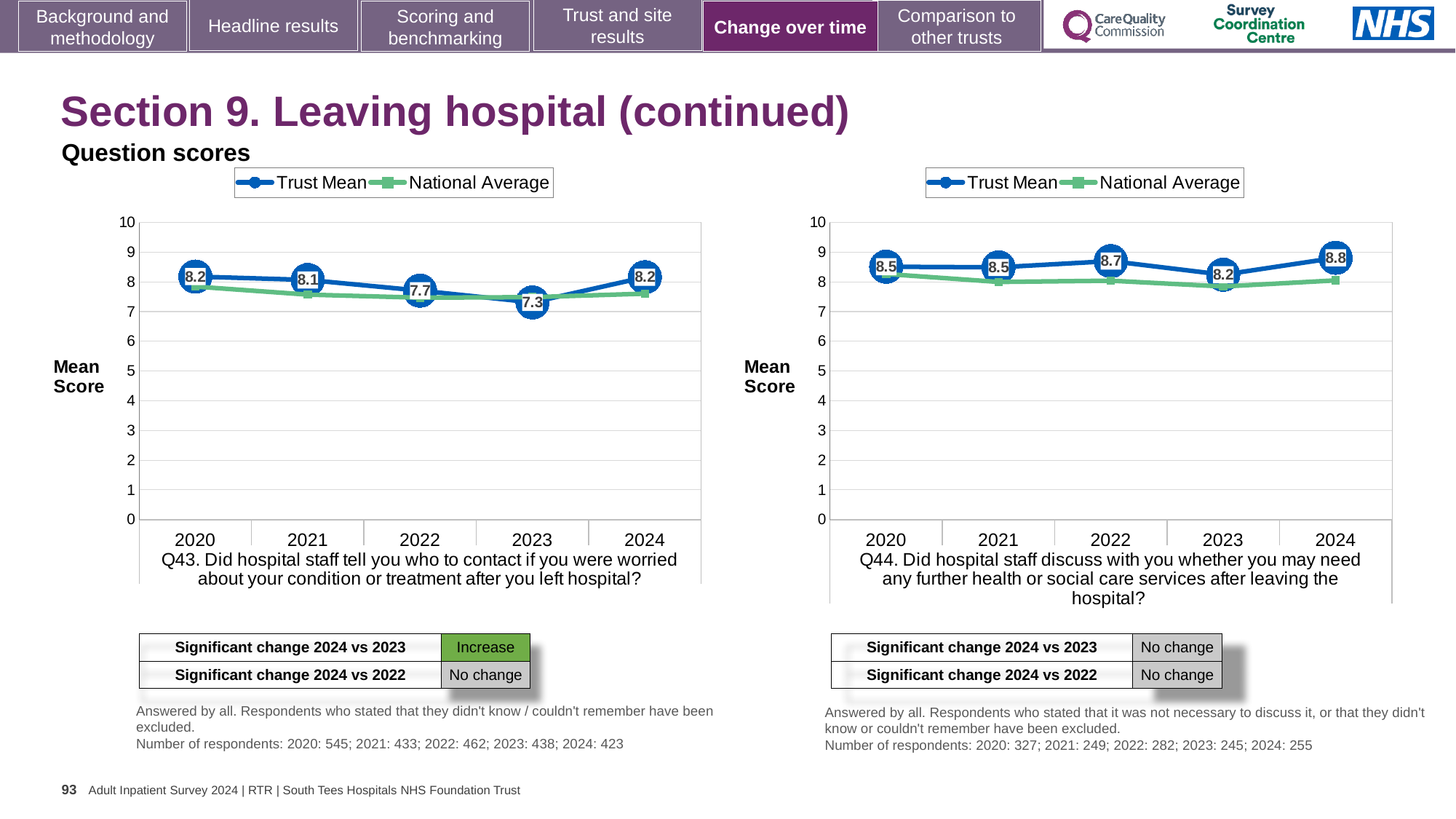
In the Q44 chart (right), what is the Trust Mean score for 2023? 8.2 In the Q43 chart (left), what is the difference between the Trust Mean scores for 2024 and 2023? 0.9 In the Q43 chart (left), what is the Trust Mean score for 2023? 7.3 How many years are plotted on the x axis of the Q43 chart (left)? 5 In the Q44 chart (right), which year has the highest Trust Mean score? 2024 In the Q44 chart (right), what is the Trust Mean score for 2024? 8.8 In the Q44 chart (right), is the Trust Mean score for 2022 larger or smaller than the Trust Mean score for 2023? larger How many series does the legend of the Q44 chart (right) list? 2 In the Q43 chart (left), is the National Average for 2020 greater or less than 7? greater In the Q44 chart (right), what is the difference between the Trust Mean scores for 2024 and 2023? 0.6 In the Q43 chart (left), what is the Trust Mean score for 2022? 7.7 In the Q43 chart (left), which year has the lowest Trust Mean score? 2023